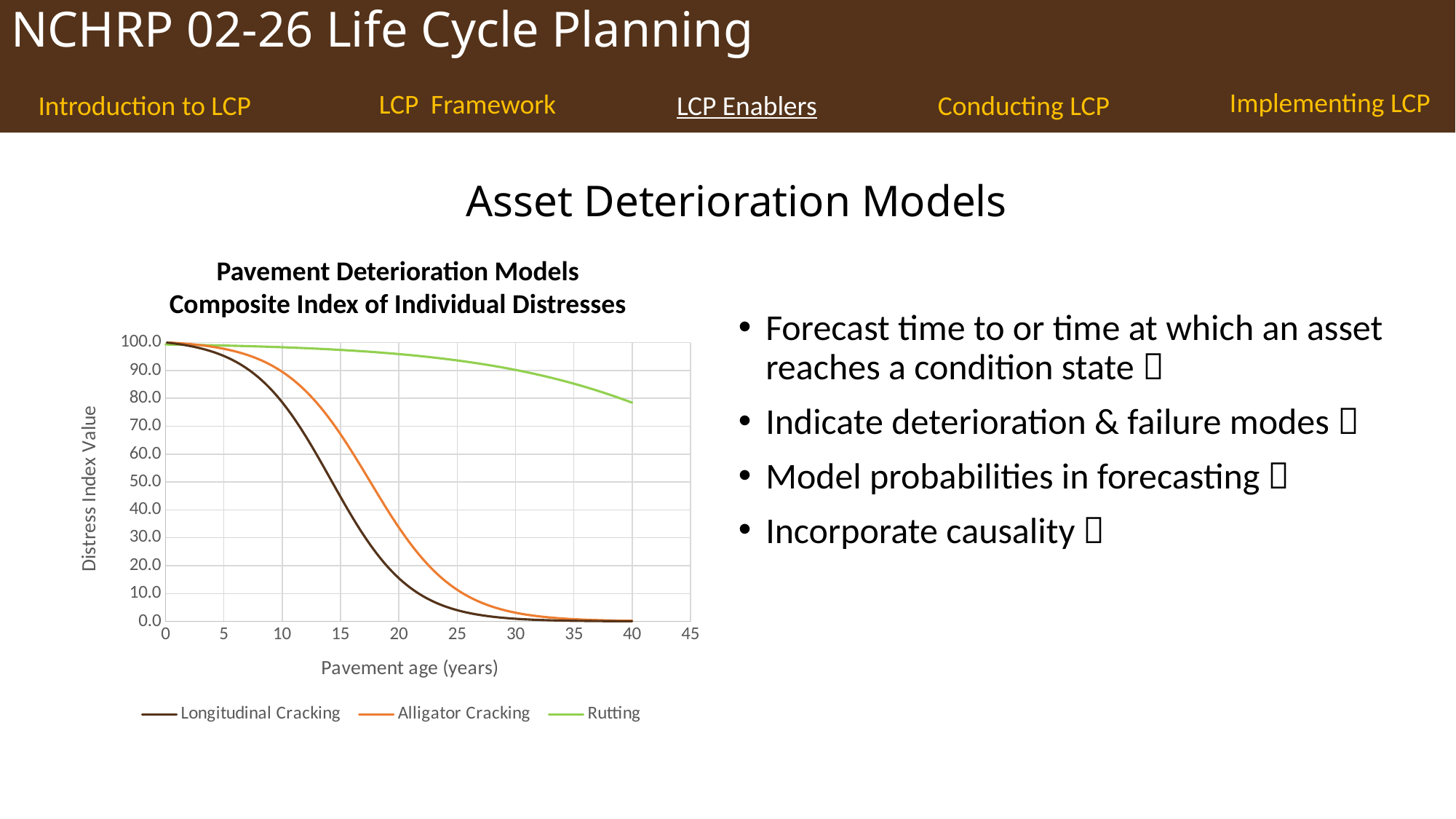
What kind of chart is shown on the slide? Line chart At a pavement age of 20 years, which series has the larger Distress Index Value, Rutting or Longitudinal Cracking? Rutting What is the label of the x axis of the chart? Pavement age (years) At a pavement age of 15 years, which series has the larger Distress Index Value, Alligator Cracking or Longitudinal Cracking? Alligator Cracking How many series does the legend of the chart list? 3 What is the title of the chart? Pavement Deterioration Models Composite Index of Individual Distresses Is the Distress Index Value for Longitudinal Cracking at a pavement age of 20 years greater or less than 30.0? less Do the Distress Index Values rise or fall as pavement age increases? Fall Is the Distress Index Value for Alligator Cracking at a pavement age of 10 years greater or less than 80.0? greater Is the Distress Index Value for Rutting at a pavement age of 40 years greater or less than 70.0? greater Which series has the highest Distress Index Value at a pavement age of 40 years? Rutting Which series has the lowest Distress Index Value at a pavement age of 15 years? Longitudinal Cracking